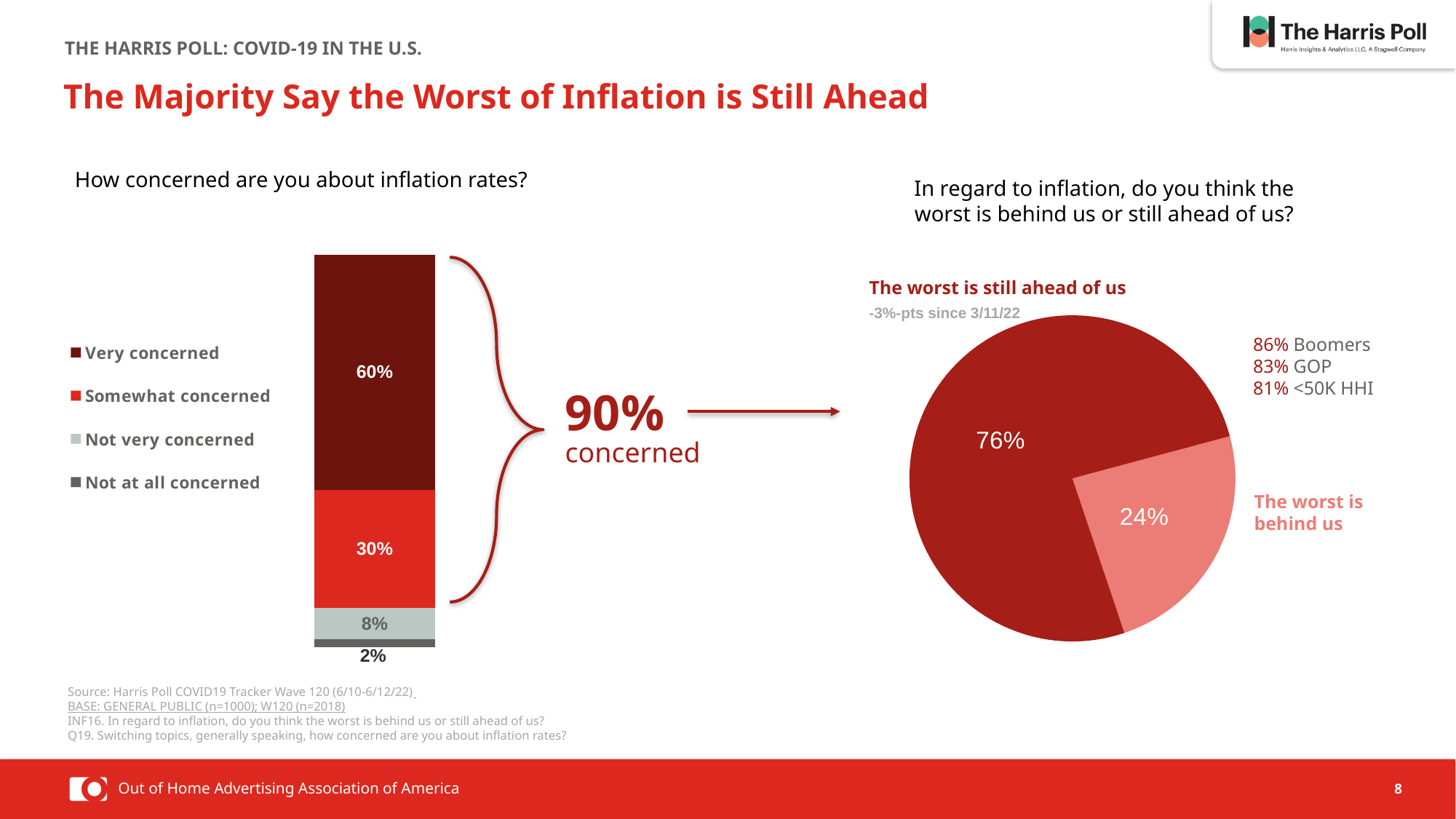
In the stacked bar chart on the left, which response category has the largest share? Very concerned In the stacked bar chart on the left, what percentage of respondents are 'Somewhat concerned'? 30% In the stacked bar chart on the left, what percentage of respondents are 'Not very concerned'? 8% In the stacked bar chart on the left, which response category has the smallest share? Not at all concerned In the stacked bar chart on the left, how many series does the legend list? 4 What type of chart is used on the right side of the slide to show whether the worst of inflation is behind us or ahead of us? Pie chart In the pie chart on the right, what share of respondents say the worst of inflation is still ahead of us? 76% In the pie chart on the right, what share of respondents say the worst of inflation is behind us? 24% In the stacked bar chart on the left, what percentage of respondents are 'Very concerned' about inflation rates? 60% In the pie chart on the right, which is larger: 'The worst is still ahead of us' or 'The worst is behind us'? The worst is still ahead of us In the stacked bar chart on the left, what is the difference in percentage points between 'Very concerned' and 'Somewhat concerned'? 30 In the stacked bar chart on the left, what percentage of respondents are 'Not at all concerned'? 2%